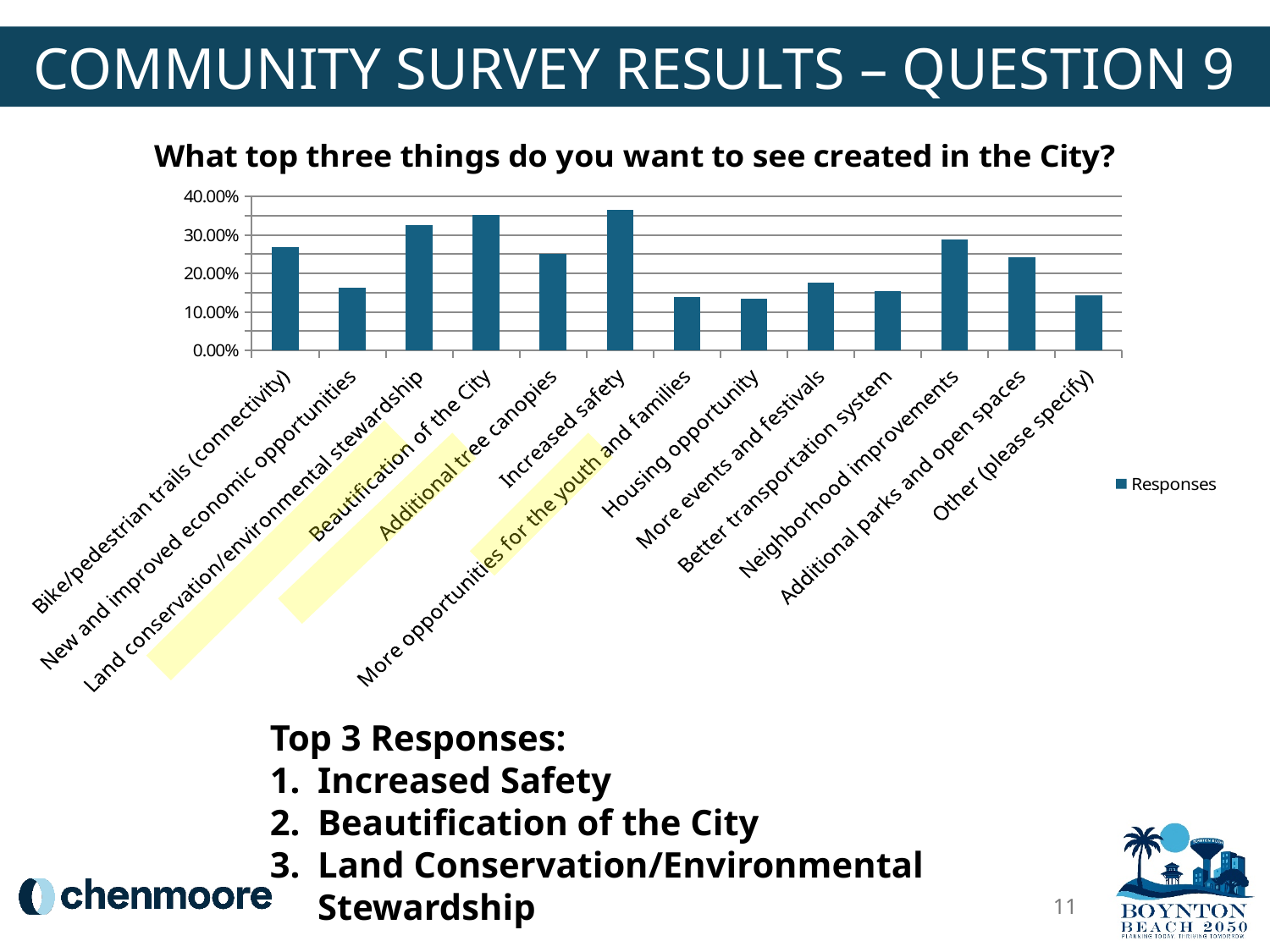
Which has a larger value: Neighborhood improvements or Better transportation system? Neighborhood improvements How many series does the chart legend list? 1 Is the value for Land conservation/environmental stewardship greater or less than 30.00%? greater What is the title of the chart? What top three things do you want to see created in the City? Is the value for New and improved economic opportunities greater or less than 20.00%? less Is the value for Housing opportunity greater or less than 20.00%? less Which has a larger value: Beautification of the City or Additional tree canopies? Beautification of the City What kind of chart is shown on the slide? bar chart Which category has the highest value in the chart? Increased safety How many categories are plotted on the x axis of the chart? 13